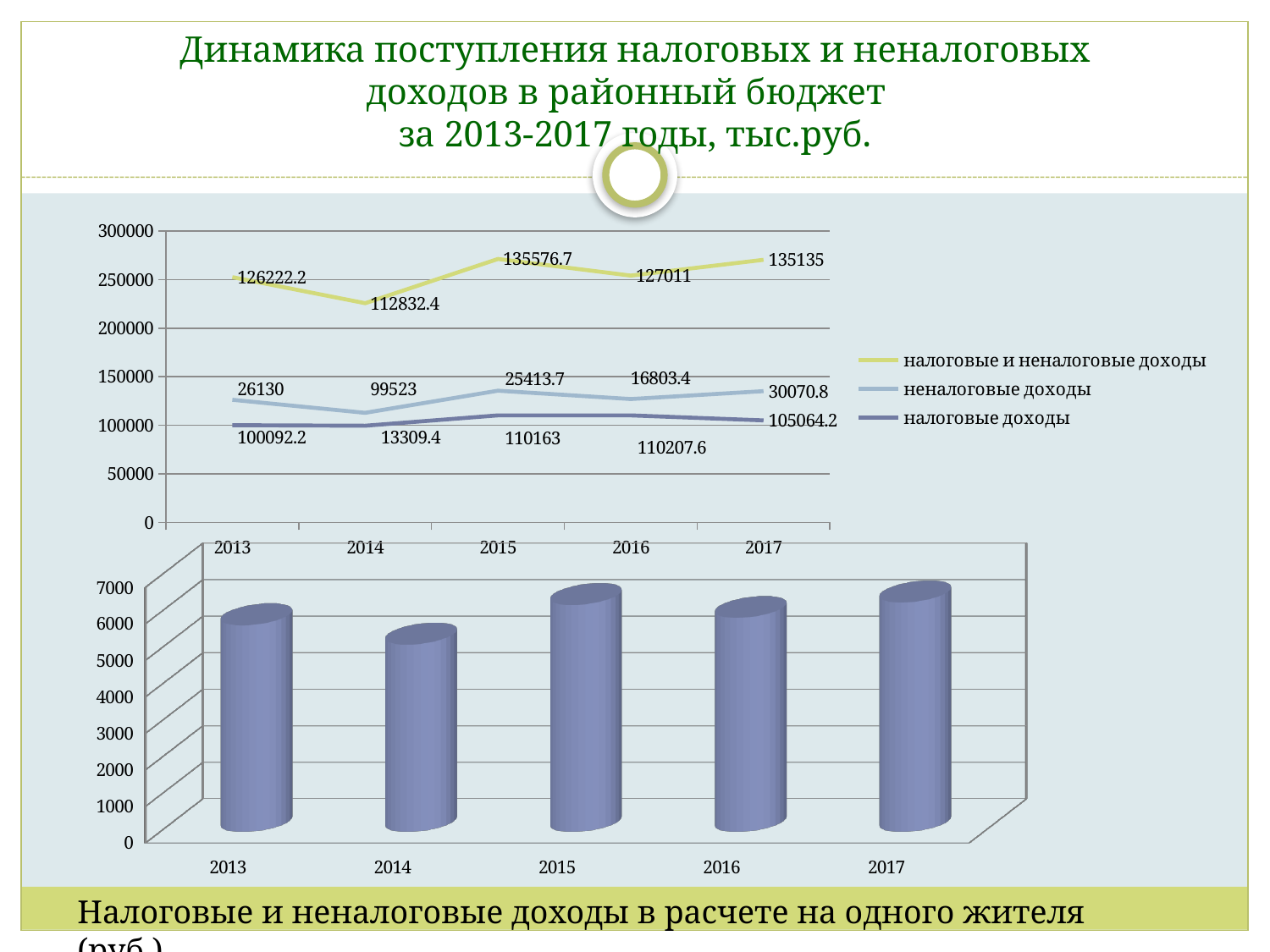
In the top line chart, is 'налоговые доходы' larger in 2016 or in 2017? 2016 In the top line chart, what is the value of 'неналоговые доходы' for 2017? 30070.8 In the bottom bar chart, is the value for 2015 greater or less than 6000? greater In the top line chart, what is the value of 'налоговые и неналоговые доходы' for 2014? 112832.4 In the top line chart, what is the value of 'налоговые и неналоговые доходы' for 2015? 135576.7 In the top line chart, which year has the lowest value for 'налоговые и неналоговые доходы'? 2014 In the top line chart, what is the difference between 'налоговые и неналоговые доходы' in 2017 and in 2016? 8124 What kind of chart is the bottom chart on the slide? bar chart In the top line chart, which year has the lowest value for 'неналоговые доходы'? 2014 In the top line chart, what is the value of 'налоговые доходы' for 2013? 100092.2 In the bottom bar chart, which year has the lowest bar? 2014 How many series does the legend of the top line chart list? 3